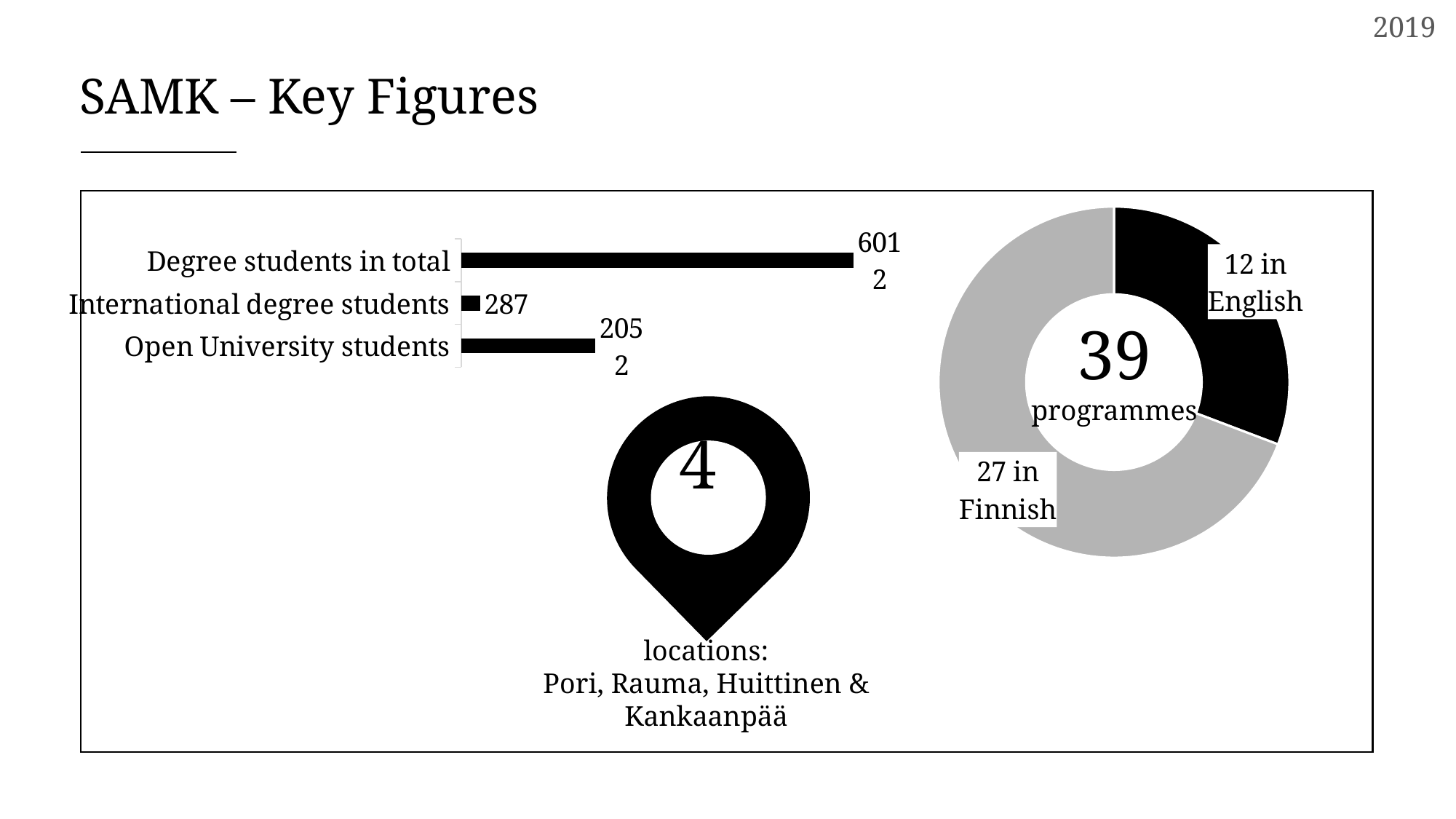
In the doughnut chart on the right, what is the total number of programmes? 39 How many categories does the bar chart on the left show? 3 In the doughnut chart on the right, how many programmes are in English? 12 In the bar chart on the left, which category has the lowest value? International degree students In the bar chart on the left, what is the value for Degree students in total? 6012 In the doughnut chart on the right, how many programmes are in Finnish? 27 In the doughnut chart on the right, how many more programmes are in Finnish than in English? 15 What kind of chart is the chart on the left of the slide? Bar chart In the bar chart on the left, what is the value for International degree students? 287 In the bar chart on the left, what is the value for Open University students? 2052 In the bar chart on the left, which category has the highest value? Degree students in total In the bar chart on the left, which is larger: Open University students or International degree students? Open University students